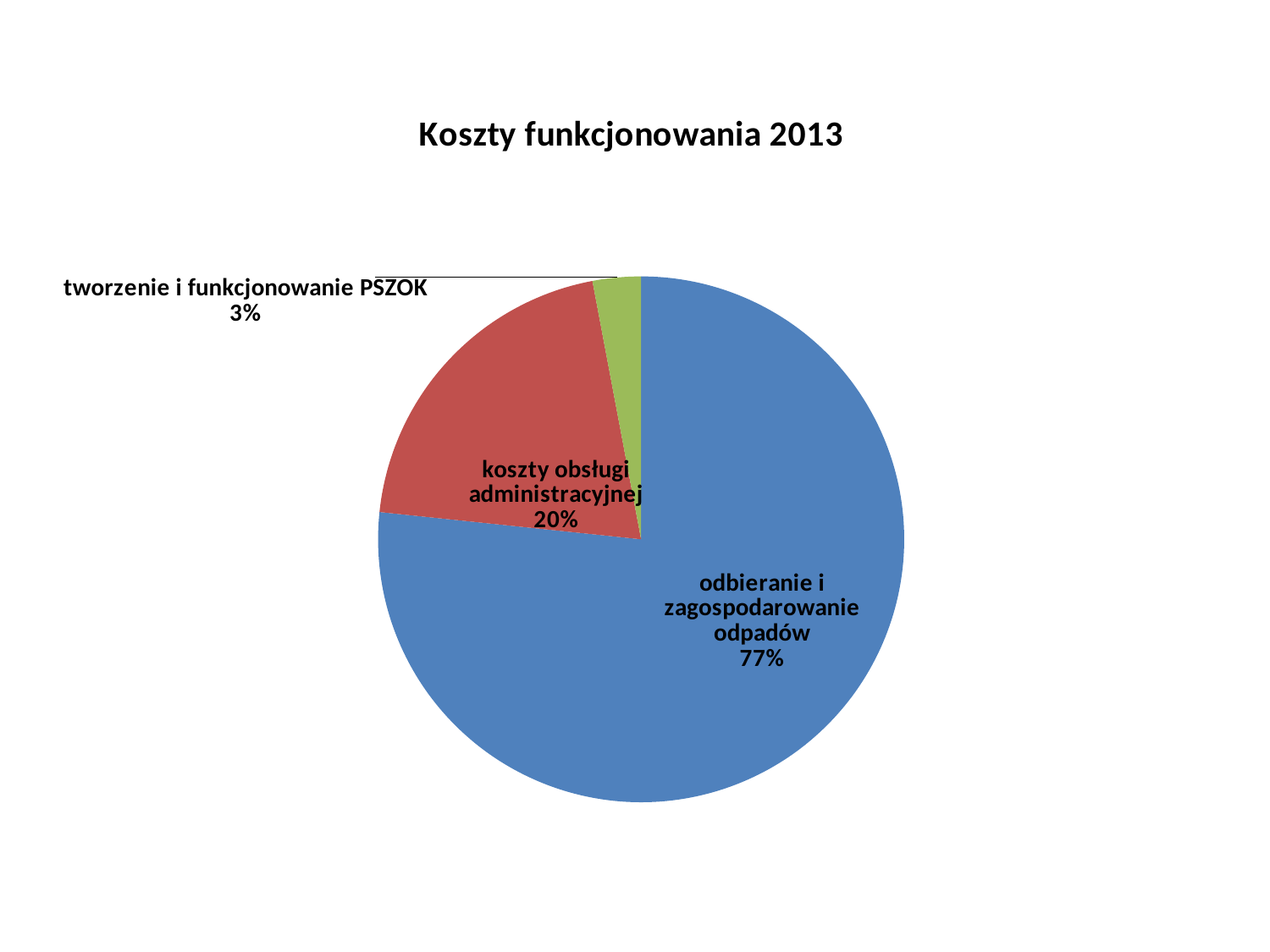
Which is larger: the share for 'koszty obsługi administracyjnej' or for 'tworzenie i funkcjonowanie PSZOK'? koszty obsługi administracyjnej What share of the pie does 'tworzenie i funkcjonowanie PSZOK' represent? 3% Which category has the largest slice of the pie? odbieranie i zagospodarowanie odpadów Which category has the smallest slice of the pie? tworzenie i funkcjonowanie PSZOK What colour is the slice for 'koszty obsługi administracyjnej'? red What share of the pie does 'odbieranie i zagospodarowanie odpadów' represent? 77% What share of the pie does 'koszty obsługi administracyjnej' represent? 20% What is the difference in percentage points between 'koszty obsługi administracyjnej' and 'tworzenie i funkcjonowanie PSZOK'? 17 What is the difference in percentage points between 'odbieranie i zagospodarowanie odpadów' and 'koszty obsługi administracyjnej'? 57 What kind of chart is shown on the slide? pie chart What is the title of the chart? Koszty funkcjonowania 2013 How many categories are shown in the pie chart? 3